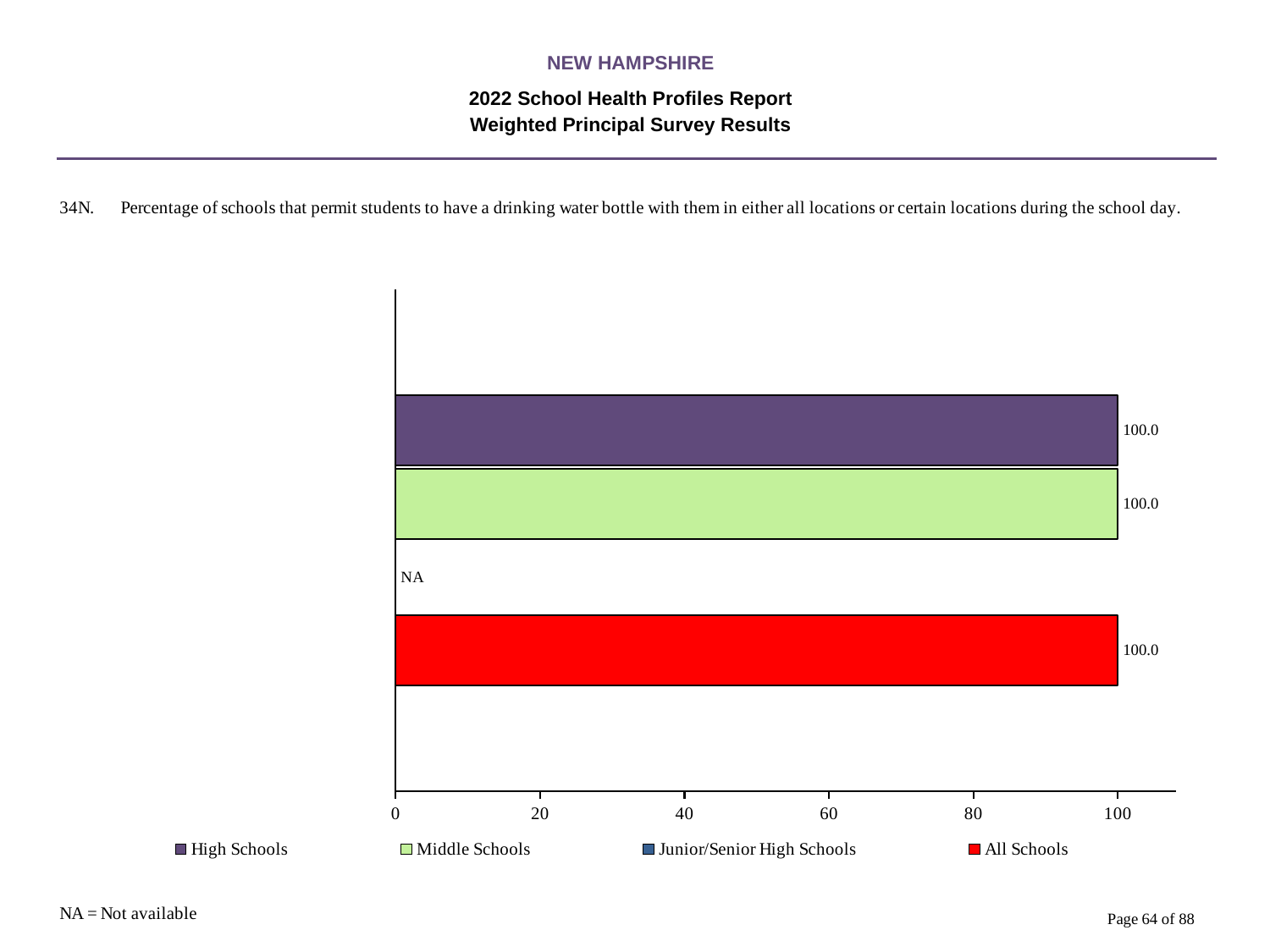
What is the difference between the values for High Schools and Middle Schools? 0.0 What does NA stand for according to the slide? Not available What kind of chart is shown on the slide? bar chart Is the value for All Schools greater or less than 80? greater What is the value for All Schools? 100.0 What is the value for Middle Schools? 100.0 What is the highest tick value shown on the x axis? 100 What colour is the bar for All Schools? red How many series does the legend list? 4 How many bars are plotted on the chart? 3 What is the value for High Schools? 100.0 What is shown for Junior/Senior High Schools? NA